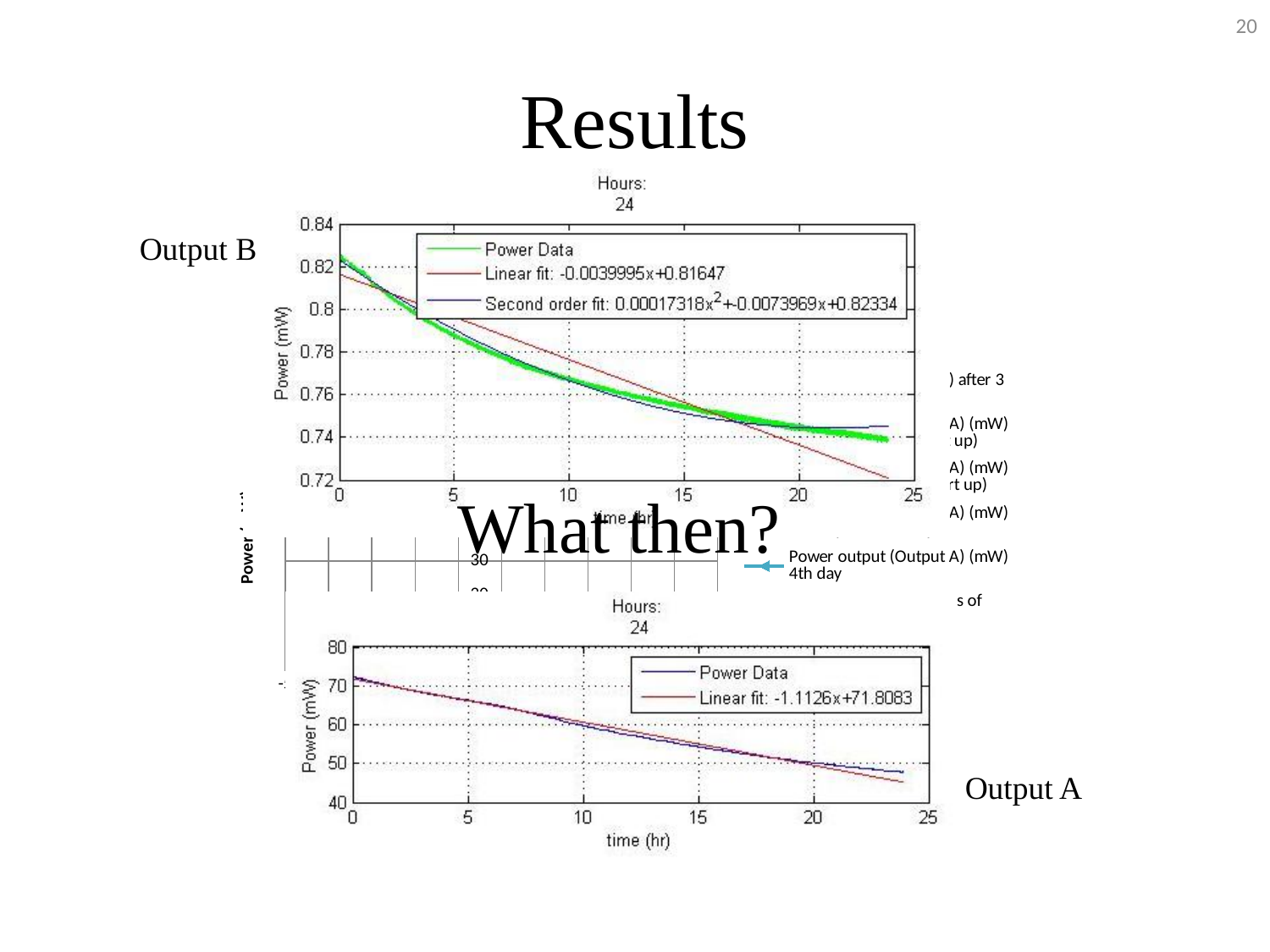
What kind of chart is the Output B chart at the top of the slide? line chart What is the y-axis label of the Output B chart? Power (mW) In the Output A chart, is the power data value at 20 hours greater or less than 60 mW? less How many series does the legend of the Output B chart list? 3 In the Output B chart, is the power data value at 20 hours greater or less than 0.76 mW? less What is the linear fit equation shown in the legend of the Output A chart? -1.1126x+71.8083 In the Output B chart, does the power data rise or fall as time increases? fall In the Output B chart, is the power data value at 0 hours greater or less than 0.80 mW? greater In the Output A chart, does the power data rise or fall as time increases? fall What kind of chart is the Output A chart at the bottom of the slide? line chart How many series does the legend of the Output A chart list? 2